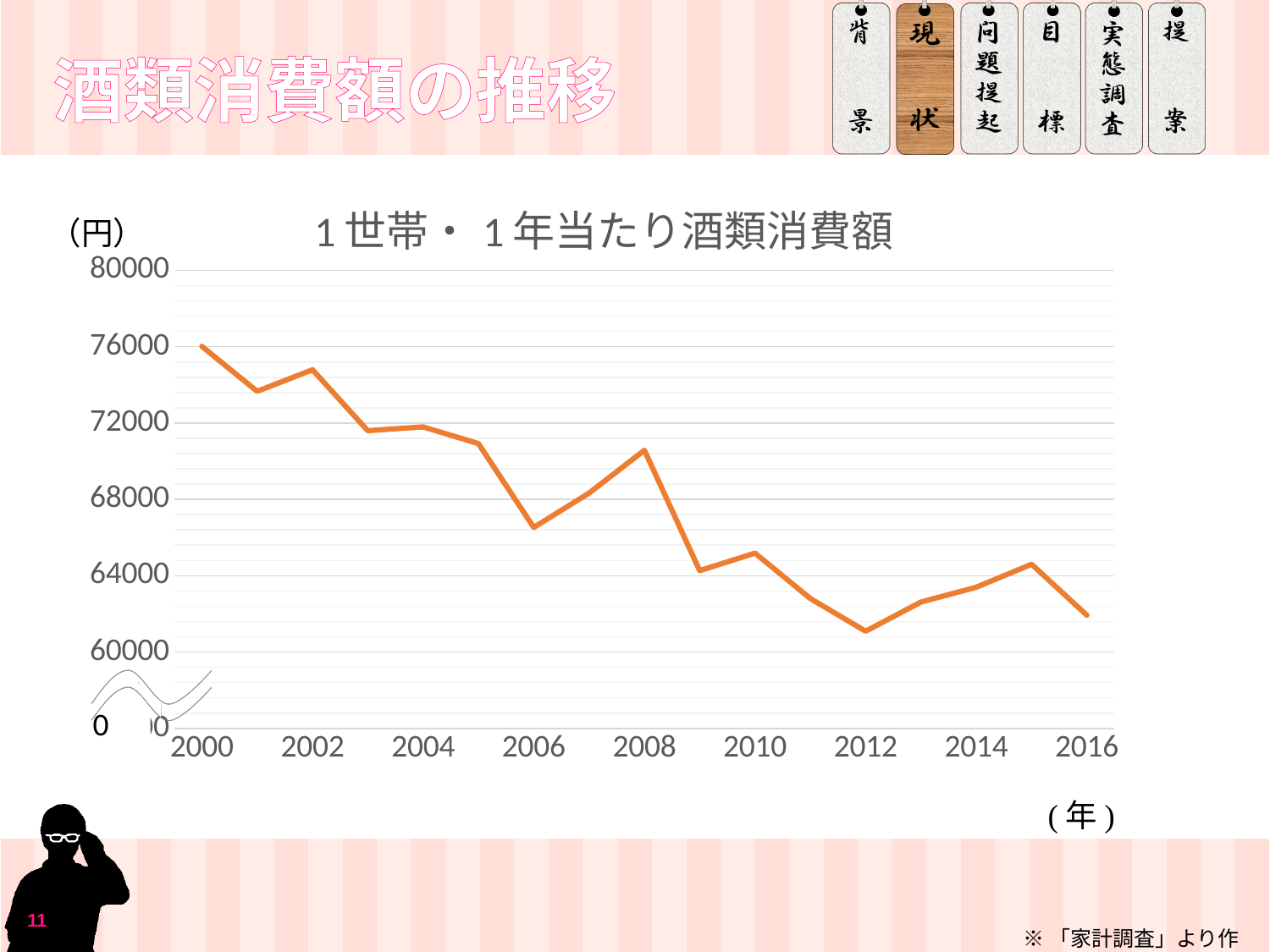
Which year has the highest alcohol consumption value in the chart? 2000 Is the value for 2012 greater or less than 64000? less Overall, do the values rise or fall from 2000 to 2016? fall Is the value for 2006 greater or less than 68000? less What unit is shown for the vertical axis of the chart? 円 Is the value for 2008 greater or less than 68000? greater What is the title of the chart? 1世帯・1年当たり酒類消費額 Which year has the lowest alcohol consumption value in the chart? 2012 Which year has the larger value, 2008 or 2009? 2008 What kind of chart is shown on the slide? line chart Which year has the larger value, 2000 or 2016? 2000